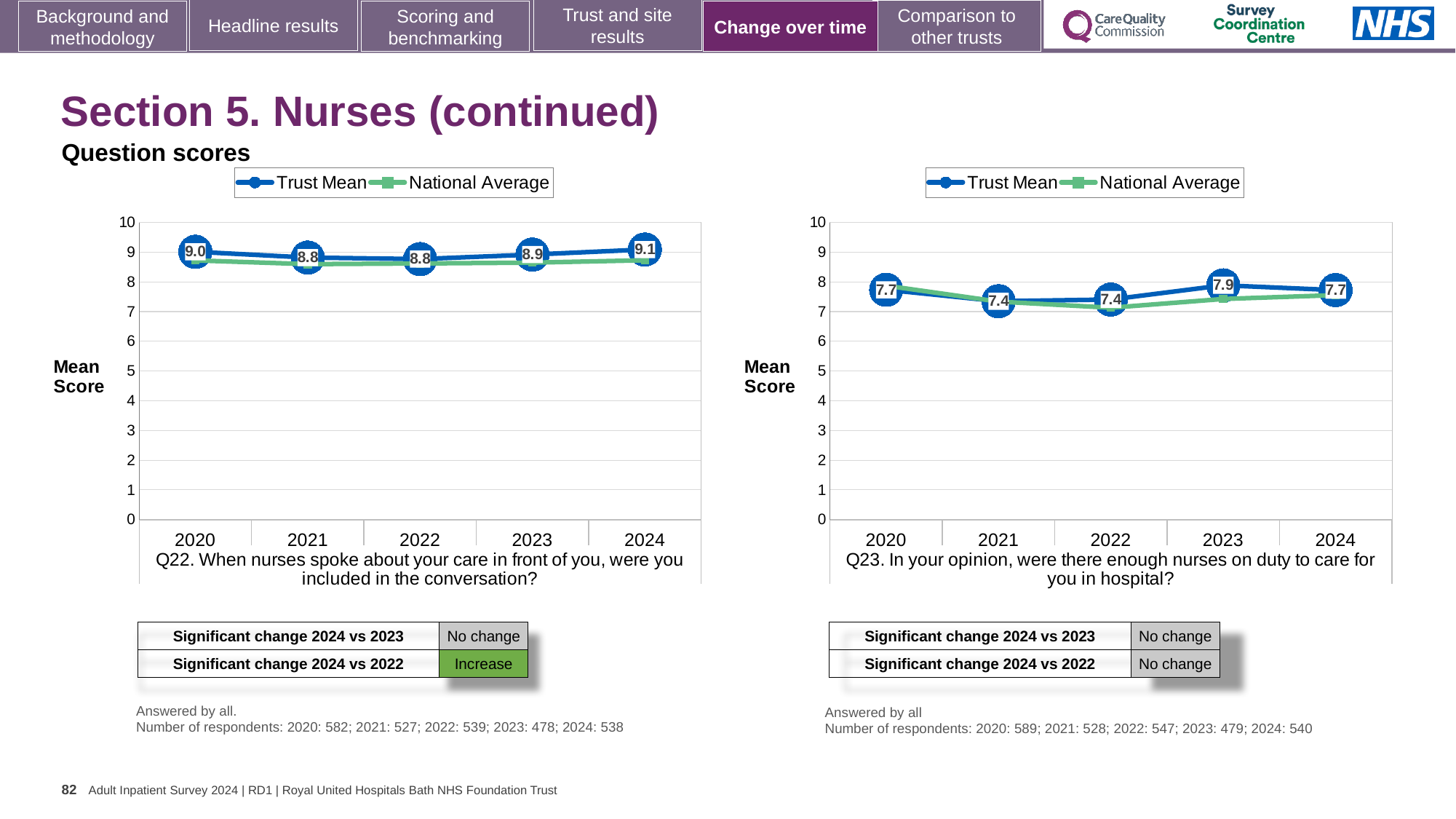
In the Q23 chart (right), which year has the highest Trust Mean score? 2023 In the Q23 chart (right), what is the Trust Mean score for 2023? 7.9 What type of chart is used for Q22 (left)? Line chart In the Q23 chart (right), what is the difference between the Trust Mean scores for 2023 and 2022? 0.5 In the Q23 chart (right), is the National Average value for 2022 greater or less than 8? less In the Q22 chart (left), which year has the highest Trust Mean score? 2024 In the Q22 chart (left), what is the Trust Mean score for 2024? 9.1 In the Q22 chart (left), what is the Trust Mean score for 2020? 9.0 In the Q23 chart (right), what is the Trust Mean score for 2021? 7.4 In the Q22 chart (left), is the Trust Mean score for 2024 larger than the Trust Mean score for 2021? Yes, 2024 (9.1) is larger than 2021 (8.8) How many series does the legend of the Q23 chart (right) list? 2 How many years are plotted on the x axis of the Q22 chart (left)? 5